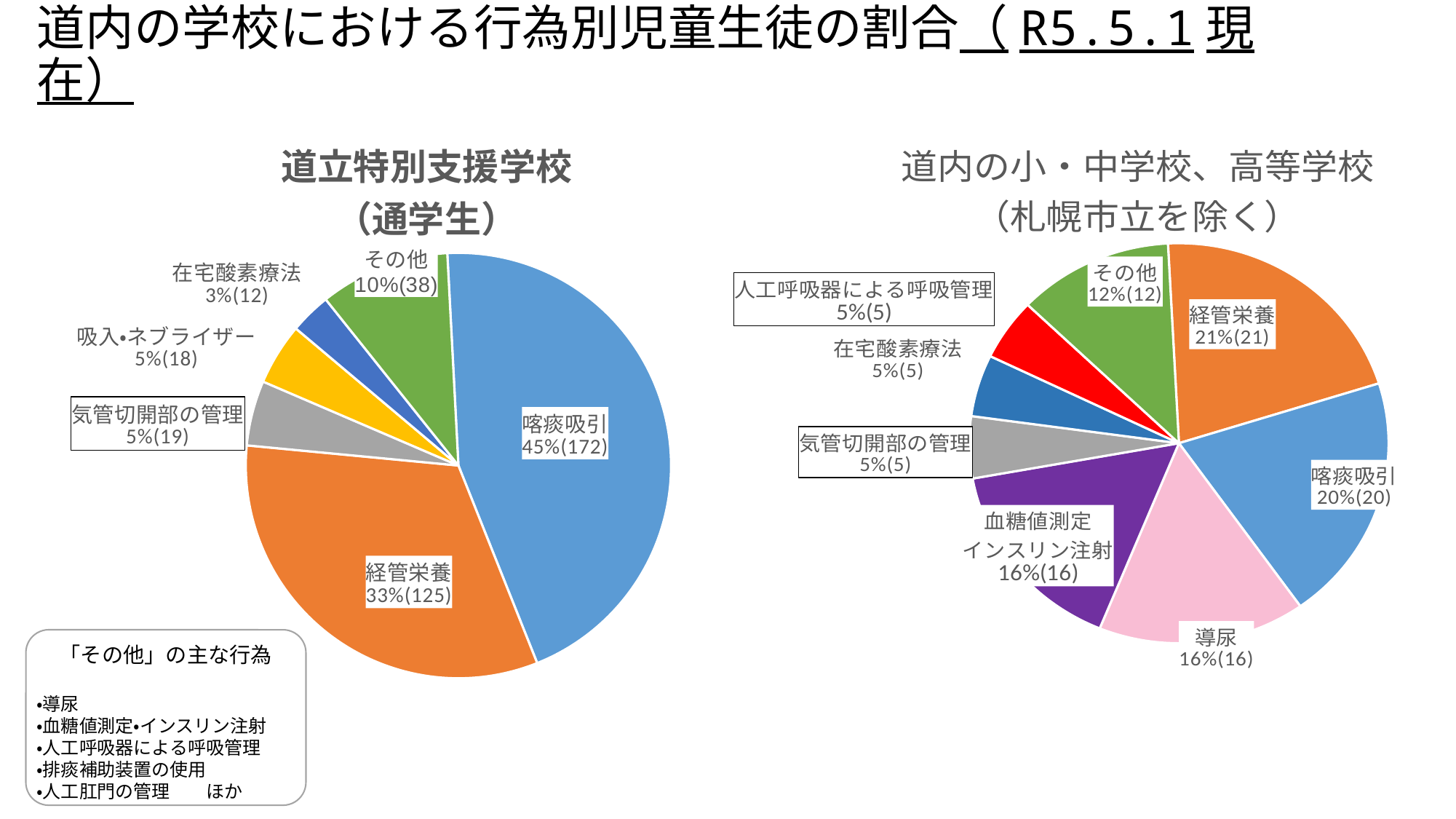
In the 道立特別支援学校（通学生） chart, what is the share for 喀痰吸引? 45%(172) In the 道立特別支援学校（通学生） chart, what is the value shown for 経管栄養? 33%(125) In the 道内の小・中学校、高等学校（札幌市立を除く） chart, which is larger: その他 or 気管切開部の管理? その他 In the 道内の小・中学校、高等学校（札幌市立を除く） chart, which category has the largest share? 経管栄養 In the 道内の小・中学校、高等学校（札幌市立を除く） chart, what is the value shown for 導尿? 16%(16) In the 道立特別支援学校（通学生） chart, what colour is the 喀痰吸引 slice? blue In the 道内の小・中学校、高等学校（札幌市立を除く） chart, what is the share for 経管栄養? 21%(21) In the 道内の小・中学校、高等学校（札幌市立を除く） chart, how many slices does the pie have? 8 In the 道立特別支援学校（通学生） chart, what is the difference in count between 喀痰吸引 (172) and 経管栄養 (125)? 47 In the 道立特別支援学校（通学生） chart, which category has the smallest share? 在宅酸素療法 In the 道立特別支援学校（通学生） chart, how many slices does the pie have? 6 What type of chart is used for 道立特別支援学校（通学生）? pie chart